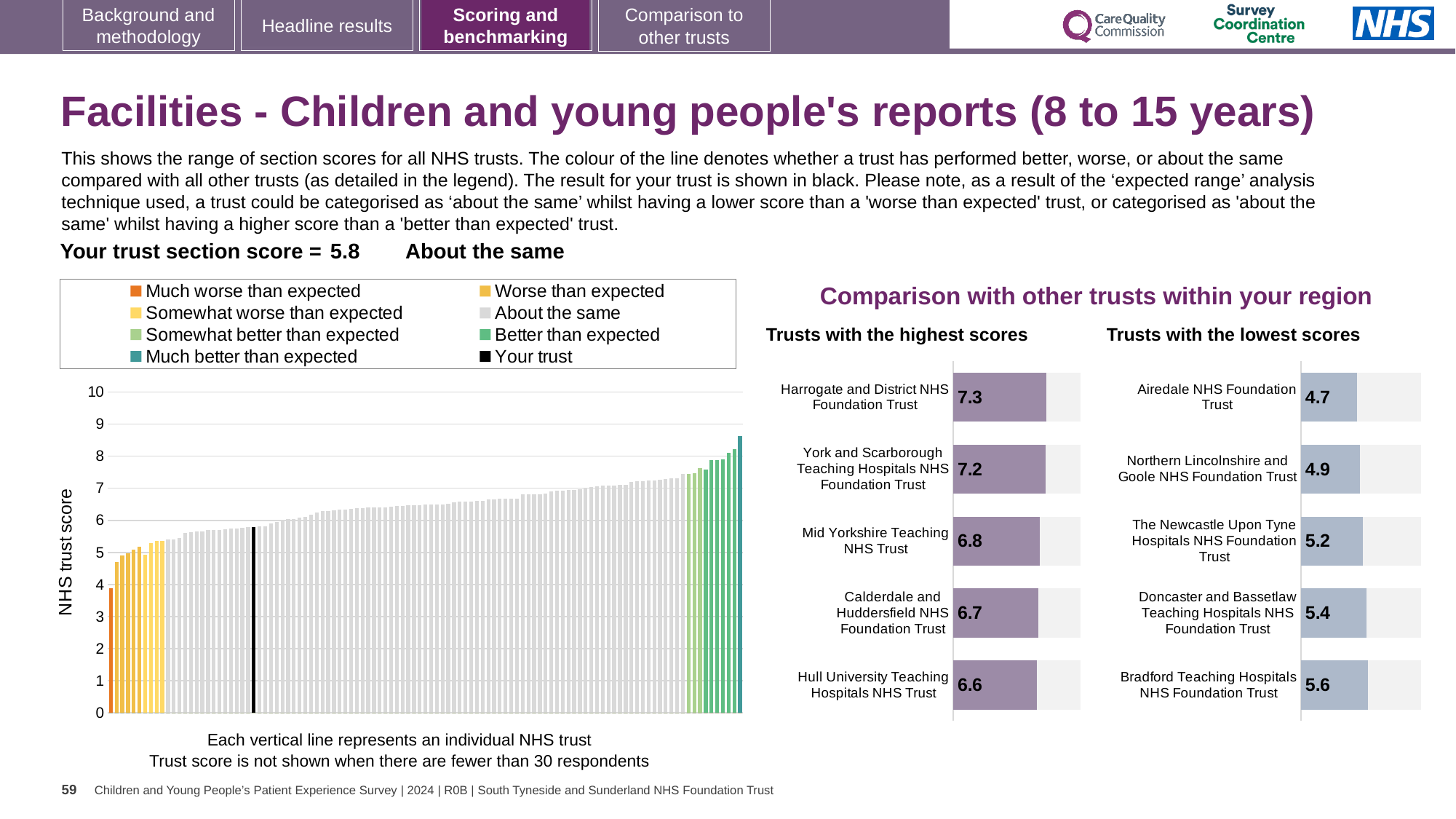
In the 'Trusts with the highest scores' chart, what is the difference between the scores of Harrogate and District NHS Foundation Trust and Hull University Teaching Hospitals NHS Trust? 0.7 In the 'Trusts with the lowest scores' chart, what is the difference between the scores of Bradford Teaching Hospitals NHS Foundation Trust and Airedale NHS Foundation Trust? 0.9 In the 'Trusts with the lowest scores' chart, which trust has the highest score shown? Bradford Teaching Hospitals NHS Foundation Trust In the 'Trusts with the highest scores' chart, which trust has the lowest score shown? Hull University Teaching Hospitals NHS Trust How many entries does the legend of the main 'NHS trust score' chart list? 8 In the 'Trusts with the lowest scores' chart, which trust has the lowest score? Airedale NHS Foundation Trust In the 'Trusts with the highest scores' chart, what is the score for Harrogate and District NHS Foundation Trust? 7.3 In the main 'NHS trust score' chart, do the bar values rise or fall from left to right? rise In the 'Trusts with the highest scores' chart, which has the higher score: Mid Yorkshire Teaching NHS Trust or Calderdale and Huddersfield NHS Foundation Trust? Mid Yorkshire Teaching NHS Trust In the 'Trusts with the lowest scores' chart, what is the score for The Newcastle Upon Tyne Hospitals NHS Foundation Trust? 5.2 How many trusts are listed in the 'Trusts with the lowest scores' chart? 5 In the main 'NHS trust score' chart, what is the section score for your trust (the black bar)? 5.8